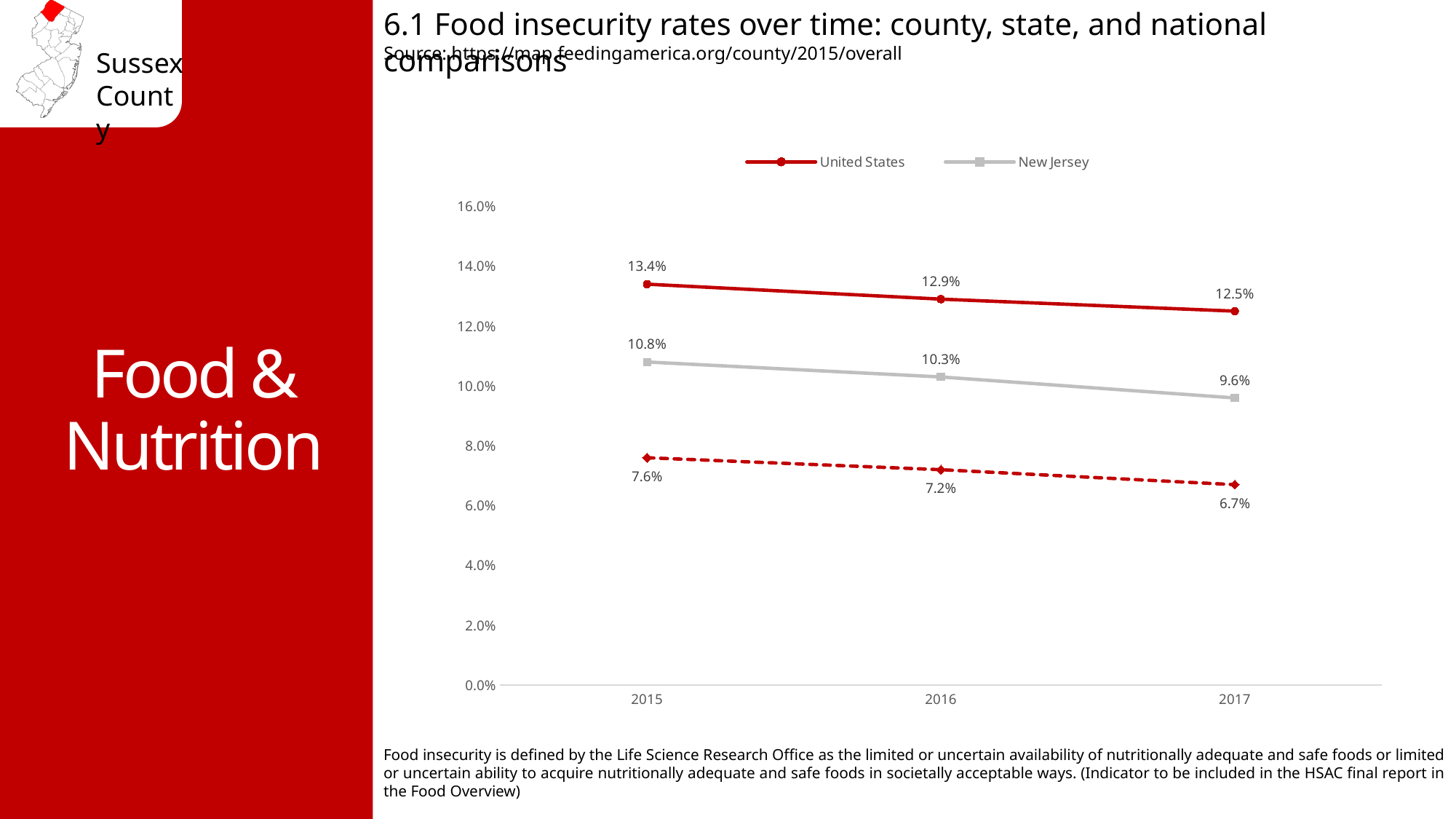
Do the United States values rise or fall from 2015 to 2017? fall What is the difference between the United States and New Jersey rates in 2016? 2.6% Which is larger in 2015, the United States rate or the New Jersey rate? United States In which year was the New Jersey rate highest? 2015 What was the United States food insecurity rate in 2015? 13.4% How many series does the legend list? 2 How many years are shown on the x axis? 3 What was the New Jersey food insecurity rate in 2017? 9.6% What value does the dashed line show for 2016? 7.2% What type of chart is shown on the slide? line chart In which year was the United States rate lowest? 2017 What was the United States food insecurity rate in 2017? 12.5%